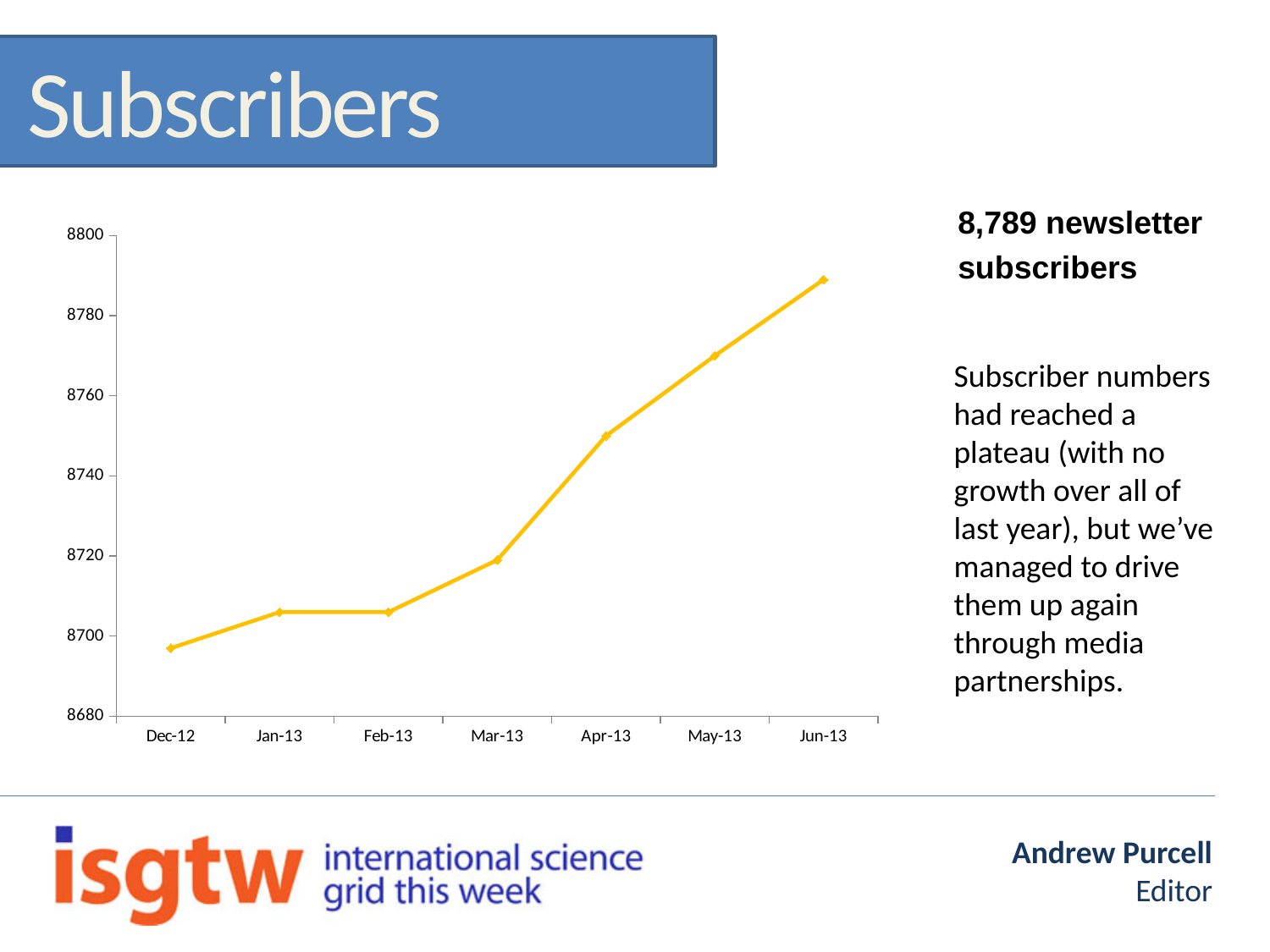
Which is larger, the value for Apr-13 or the value for Feb-13? Apr-13 Is the value for Apr-13 greater or less than 8740? greater Which month has the lowest subscriber value on the chart? Dec-12 Is the value for Jun-13 greater or less than 8780? greater Is the value for Dec-12 greater or less than 8720? less Do the values on the chart generally rise or fall from Dec-12 to Jun-13? rise How many months are plotted on the x axis of the chart? 7 Which month has the highest subscriber value on the chart? Jun-13 What is the first month shown on the x axis of the chart? Dec-12 What kind of chart is shown on the slide? line chart